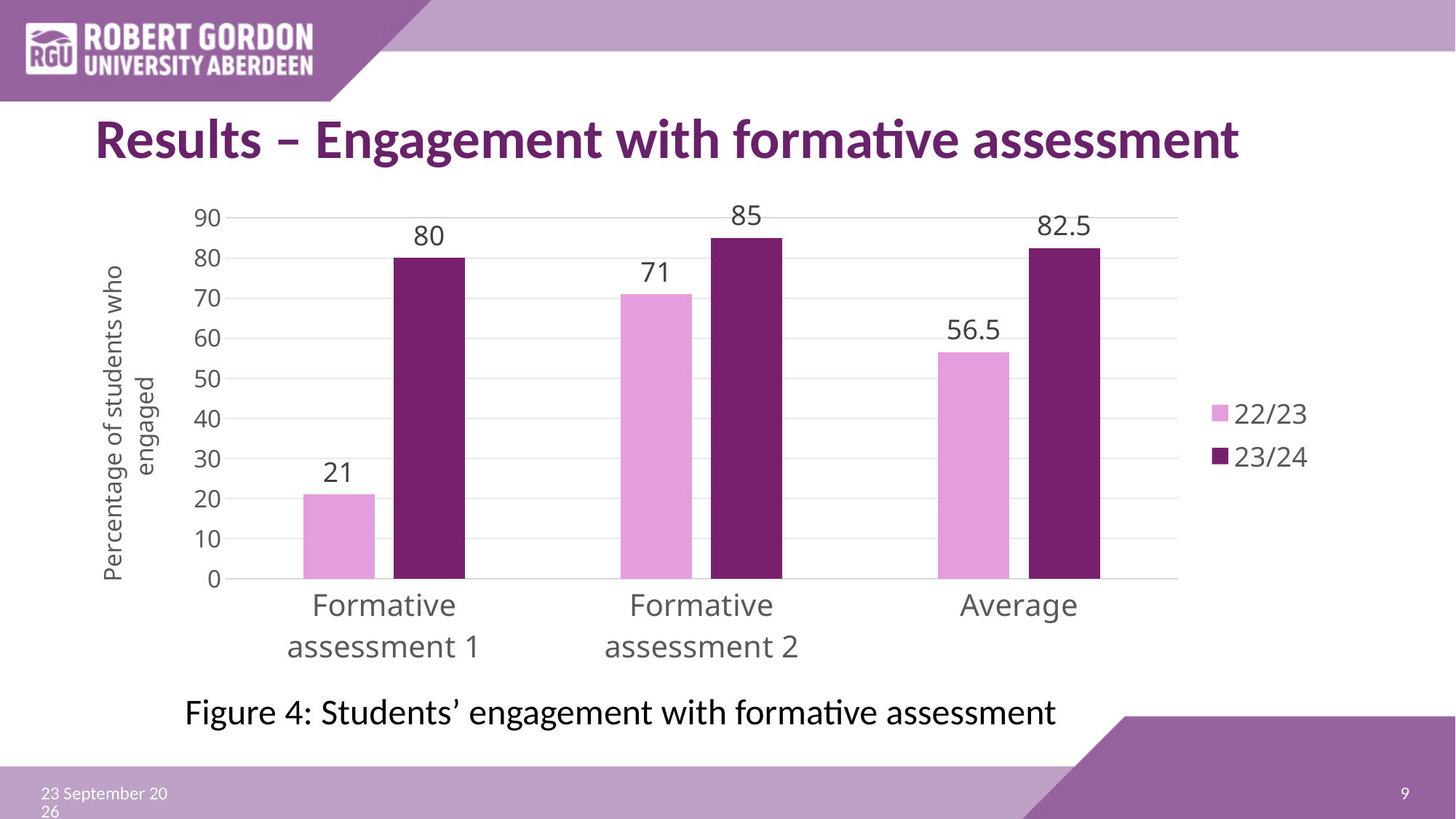
What is the difference between the 23/24 and 22/23 values for Formative assessment 1? 59 What is the Average value for the 22/23 series? 56.5 How many categories are shown on the x axis? 3 Which category has the lowest value in the 22/23 series? Formative assessment 1 Which is larger for Formative assessment 2: the 22/23 value or the 23/24 value? 23/24 Which category has the highest value in the 23/24 series? Formative assessment 2 What kind of chart is shown on the slide? Bar chart What is the Average value for the 23/24 series? 82.5 What is the value for 23/24 for Formative assessment 2? 85 What is the difference between the 23/24 and 22/23 values for Formative assessment 2? 14 What is the value for 22/23 for Formative assessment 1? 21 How many series does the legend list? 2